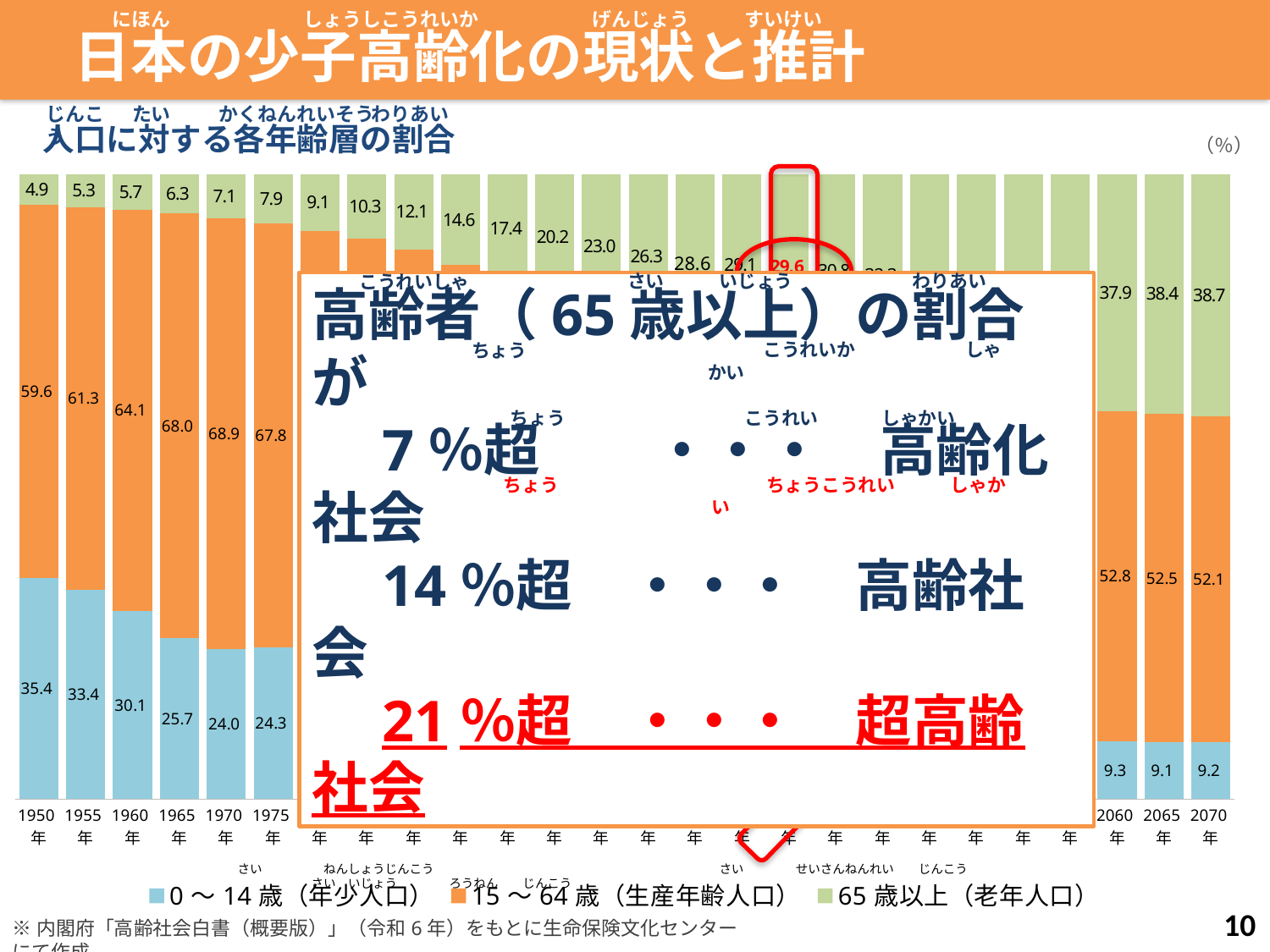
By how many percentage points does the 65歳以上 share in 2070年 exceed that in 1950年? 33.8 How many series does the legend list? 3 What is the share of the 15～64歳 (生産年齢人口) group in 2070年? 52.1 Which year has the larger 0～14歳 share, 1950年 or 2070年? 1950年 Among the labelled years, which year has the highest 65歳以上 share? 2070年 What is the share of the 65歳以上 (老年人口) group in 1950年? 4.9 Among the labelled years, which year has the lowest 0～14歳 share? 2065年 Does the share of the 65歳以上 group rise or fall from 1950年 to 2070年? rise What is the share of the 0～14歳 (年少人口) group in 1950年? 35.4 What is the total of the three labelled segments for 1950年? 99.9 What kind of chart is shown on the slide? stacked bar chart